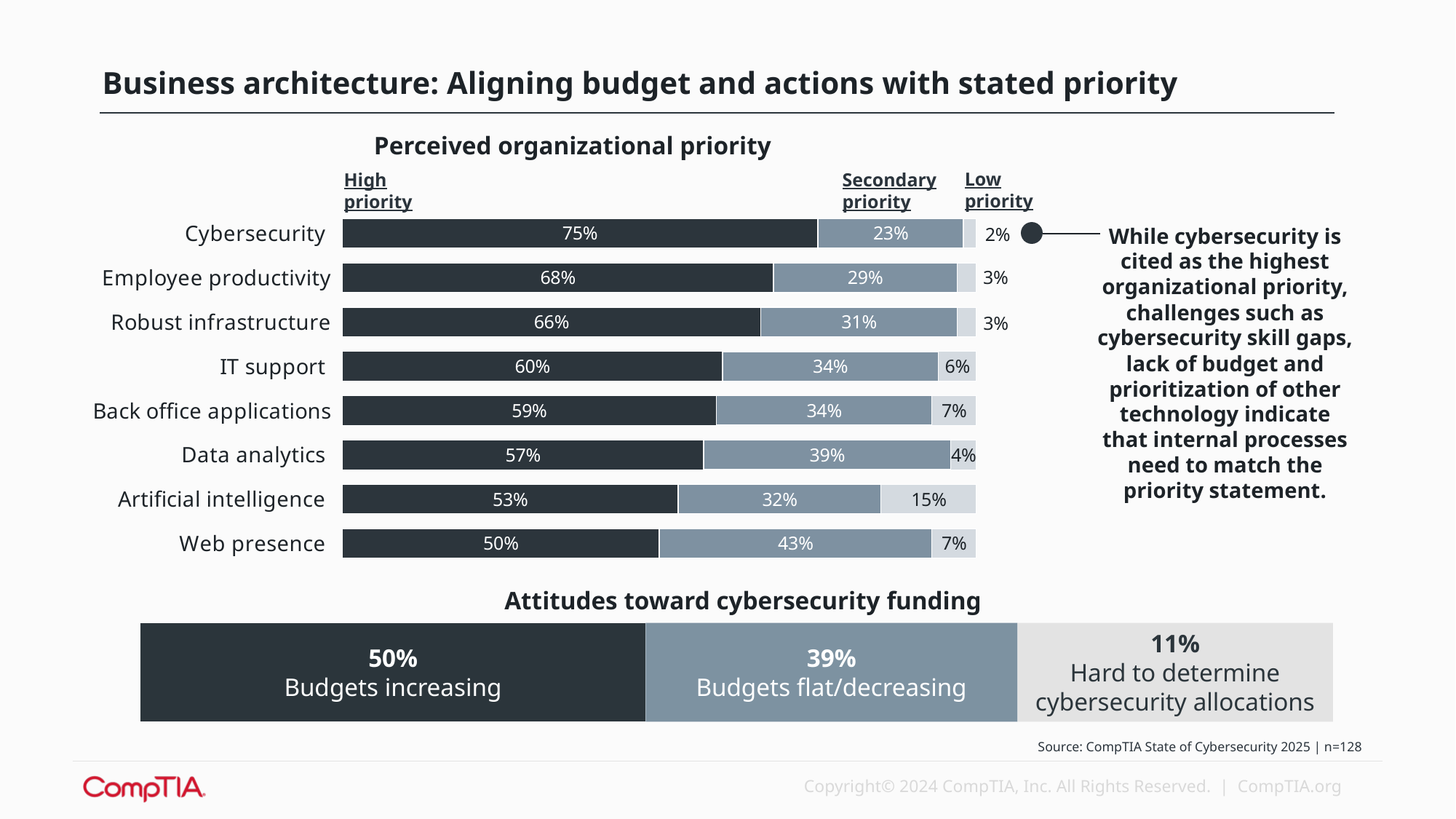
In the 'Attitudes toward cybersecurity funding' chart, what percentage report budgets increasing? 50% In the 'Perceived organizational priority' chart, what is the difference between the high priority values for Cybersecurity and Employee productivity? 7% In the 'Perceived organizational priority' chart, which has a larger secondary priority value, Data analytics or IT support? Data analytics In the 'Perceived organizational priority' chart, which category has the highest high priority value? Cybersecurity What kind of chart is the 'Perceived organizational priority' chart? Stacked bar chart In the 'Perceived organizational priority' chart, what is the low priority value for Artificial intelligence? 15% In the 'Attitudes toward cybersecurity funding' chart, what is the difference between 'Budgets flat/decreasing' and 'Hard to determine cybersecurity allocations'? 28% In the 'Perceived organizational priority' chart, what is the secondary priority value for Web presence? 43% How many series does the 'Perceived organizational priority' chart show? 3 In the 'Perceived organizational priority' chart, which category has the lowest high priority value? Web presence How many categories are shown in the 'Perceived organizational priority' chart? 8 In the 'Perceived organizational priority' chart, what percentage rate Cybersecurity as a high priority? 75%